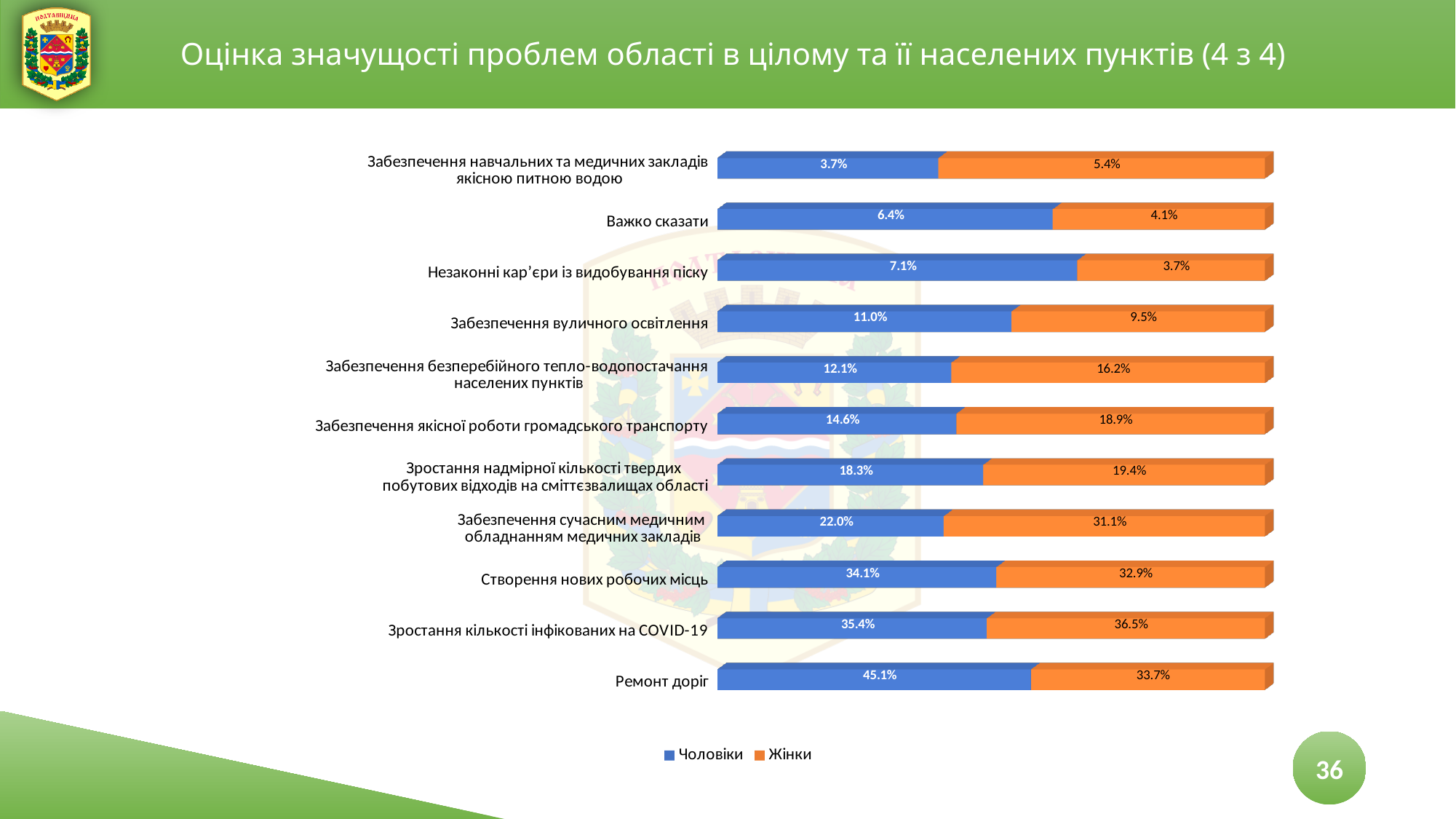
What is the value for Чоловіки for the category 'Ремонт доріг'? 45.1% What is the value for Жінки for the category 'Важко сказати'? 4.1% Which colour represents the series Жінки in the chart? Orange What is the value for Жінки for the category 'Забезпечення сучасним медичним обладнанням медичних закладів'? 31.1% How many categories (problems) are plotted in the chart? 11 For 'Забезпечення якісної роботи громадського транспорту', which is larger: the value for Чоловіки or for Жінки? Жінки Which category has the lowest value for Чоловіки? Забезпечення навчальних та медичних закладів якісною питною водою What is the difference between the Чоловіки and Жінки values for 'Ремонт доріг'? 11.4 percentage points How many series does the legend list? 2 Which category has the highest value for Жінки? Зростання кількості інфікованих на COVID-19 Which category has the highest value for Чоловіки? Ремонт доріг What kind of chart is shown on the slide? Stacked bar chart